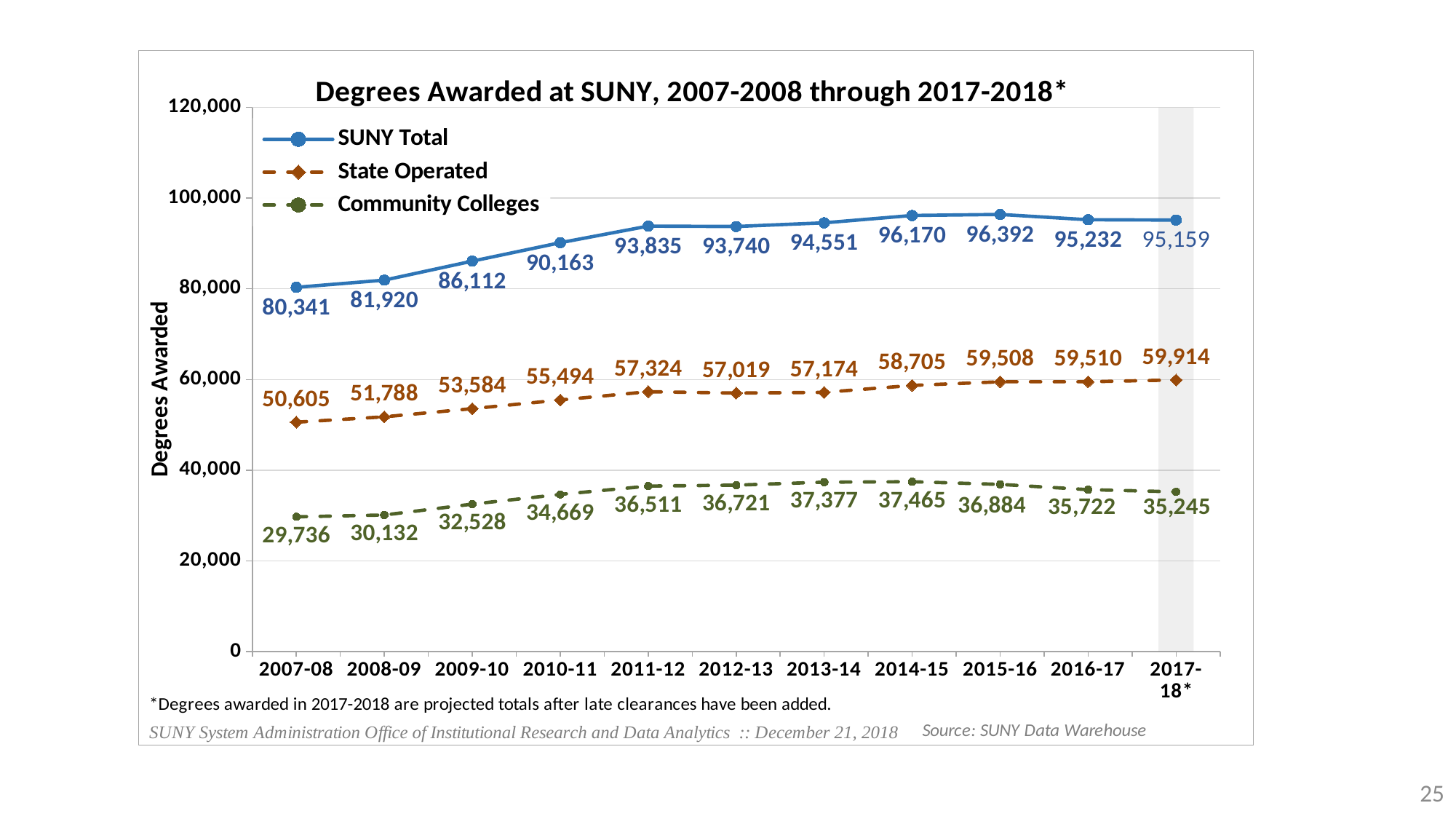
In which year is the Community Colleges value lowest? 2007-08 What kind of chart is this? Line chart What is the title of the chart? Degrees Awarded at SUNY, 2007-2008 through 2017-2018* What is the SUNY Total value for 2007-08? 80,341 How many academic years are shown on the x axis? 11 Does the State Operated series generally rise or fall from 2007-08 to 2017-18*? Rise How many series does the legend list? 3 What is the State Operated value for 2013-14? 57,174 In which year is the SUNY Total highest? 2015-16 What is the difference between the SUNY Total in 2015-16 and in 2007-08? 16,051 What is the Community Colleges value for 2017-18*? 35,245 Which is larger, the State Operated value in 2011-12 or in 2012-13? 2011-12